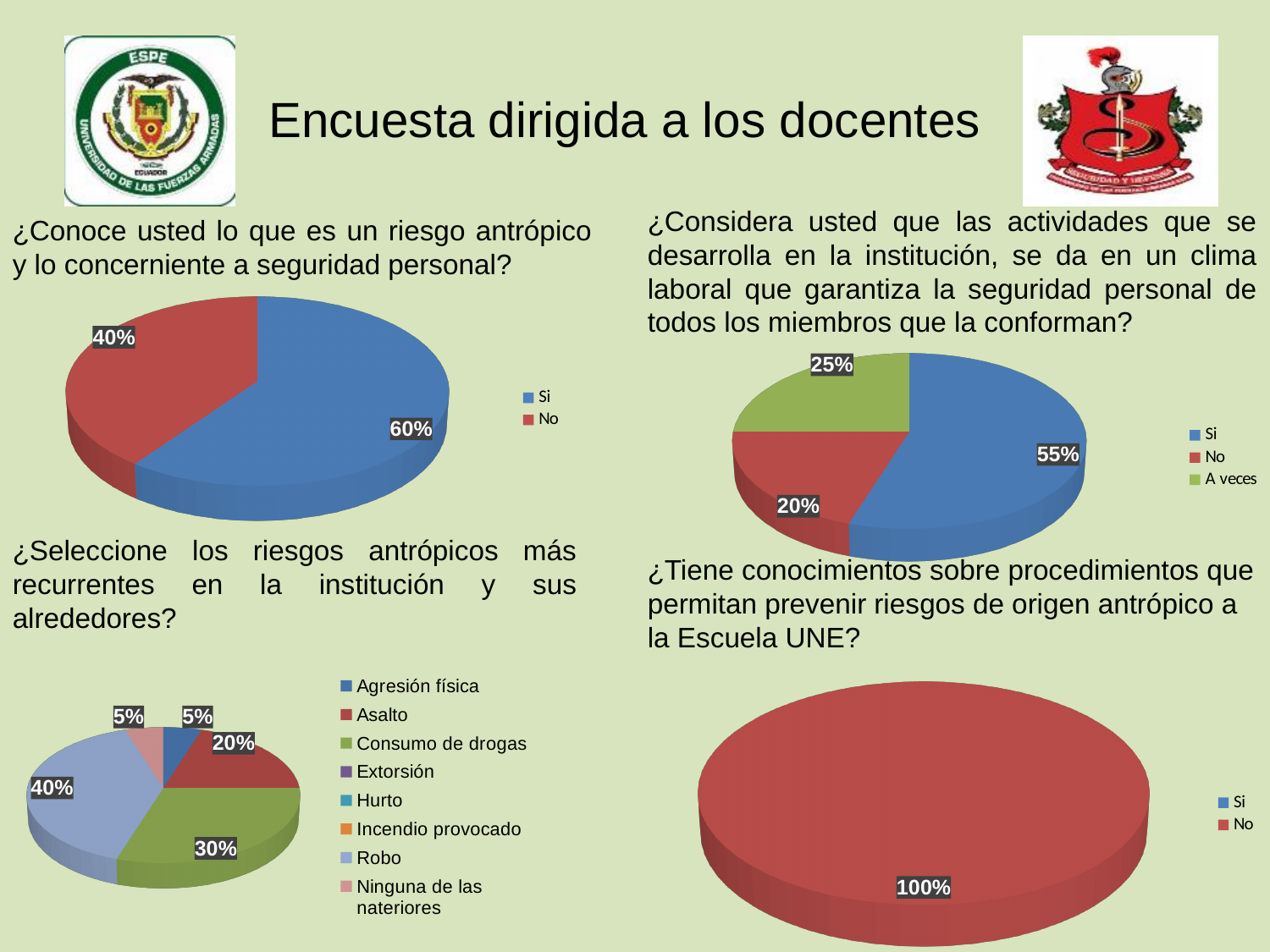
In the bottom-right pie chart (¿Tiene conocimientos sobre procedimientos...?), what share of respondents answered No? 100% In the bottom-left pie chart (¿Seleccione los riesgos antrópicos más recurrentes...?), what share corresponds to Consumo de drogas? 30% How many entries does the legend of the top-right pie chart list? 3 In the top-left pie chart (¿Conoce usted lo que es un riesgo antrópico...?), what share of respondents answered No? 40% How many entries does the legend of the bottom-left pie chart list? 8 In the top-left pie chart (¿Conoce usted lo que es un riesgo antrópico...?), what share of respondents answered Si? 60% In the top-left pie chart, what is the difference between the Si and No shares? 20% In the top-right pie chart (¿Considera usted que las actividades...?), what share answered A veces? 25% In the top-right pie chart, which answer has the smallest share? No In the bottom-left pie chart (¿Seleccione los riesgos antrópicos más recurrentes...?), what share corresponds to Robo? 40% In the bottom-left pie chart, which is larger, the share for Asalto or the share for Agresión física? Asalto In the top-right pie chart (¿Considera usted que las actividades...?), which answer has the largest share? Si